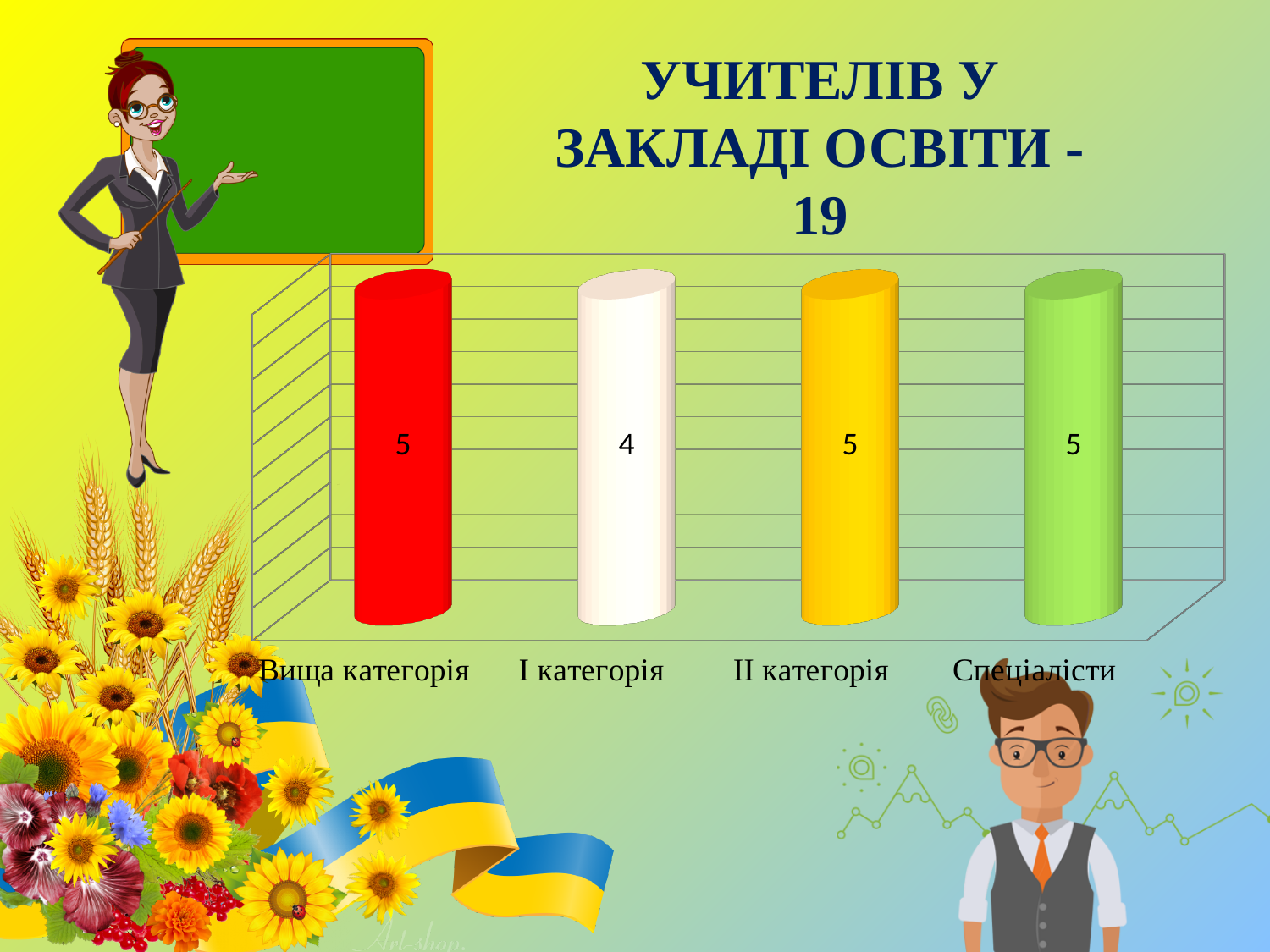
What is the value for Спеціалісти? 5 What is the value for Вища категорія? 5 What kind of chart is shown on the slide? Bar chart What is the difference between the values for Вища категорія and І категорія? 1 What is the sum of the values of all four bars? 19 What colour is the bar for Вища категорія? Red What total number of teachers is stated in the slide title? 19 What is the value for ІІ категорія? 5 How many categories are shown on the chart? 4 Which is larger, the value for І категорія or the value for Спеціалісти? Спеціалісти Which category has the lowest value? І категорія What is the value for І категорія? 4